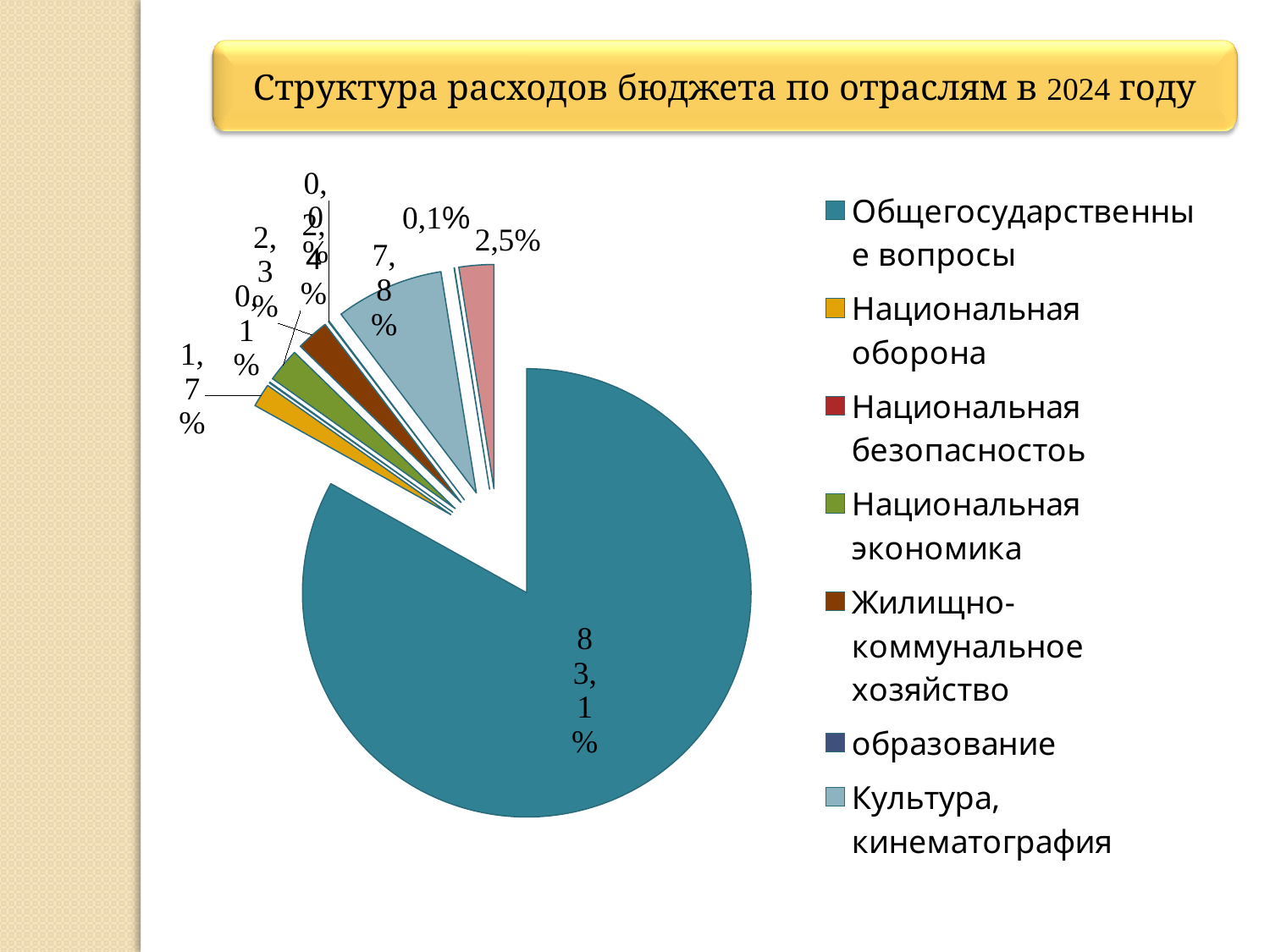
Which is larger: Культура, кинематография or Национальная экономика? Культура, кинематография What is the title of the chart? Структура расходов бюджета по отраслям в 2024 году What type of chart is shown on the slide? pie chart What is the value for Национальная оборона? 1,7% What is the value for Национальная экономика? 2,3% Which legend entry is shown in yellow? Национальная оборона What is the value for Культура, кинематография? 7,8% What is the difference between Национальная экономика and Национальная оборона? 0,6% Which category has the largest slice of the pie? Общегосударственные вопросы What is the difference between Общегосударственные вопросы and Культура, кинематография? 75,3% How many entries does the chart legend list? 7 What share of the pie is Общегосударственные вопросы? 83,1%